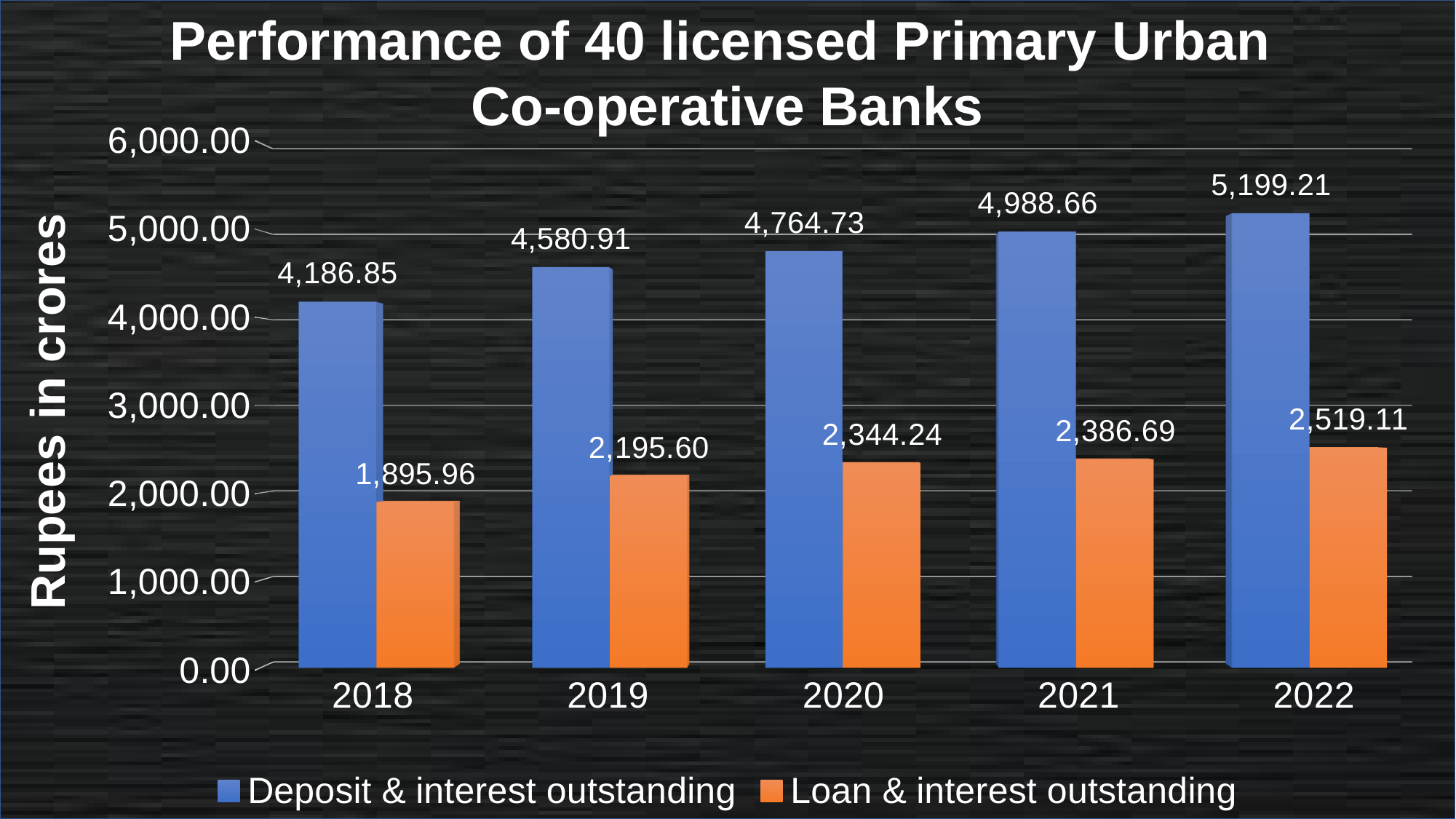
What is the difference between Deposit & interest outstanding and Loan & interest outstanding in 2022? 2,680.10 What is the Loan & interest outstanding value for 2018? 1,895.96 Which is larger: Loan & interest outstanding in 2019 or in 2020? 2020 How many series does the legend list? 2 In which year is Deposit & interest outstanding highest? 2022 Is the Deposit & interest outstanding value for 2021 greater or less than 5,000.00? less By how much did Deposit & interest outstanding increase from 2018 to 2022? 1,012.36 What is the Loan & interest outstanding value for 2021? 2,386.69 What is the trend of Loan & interest outstanding from 2018 to 2022? rising In which year is Loan & interest outstanding lowest? 2018 How many years are shown on the x axis? 5 What is the Deposit & interest outstanding value for 2020? 4,764.73